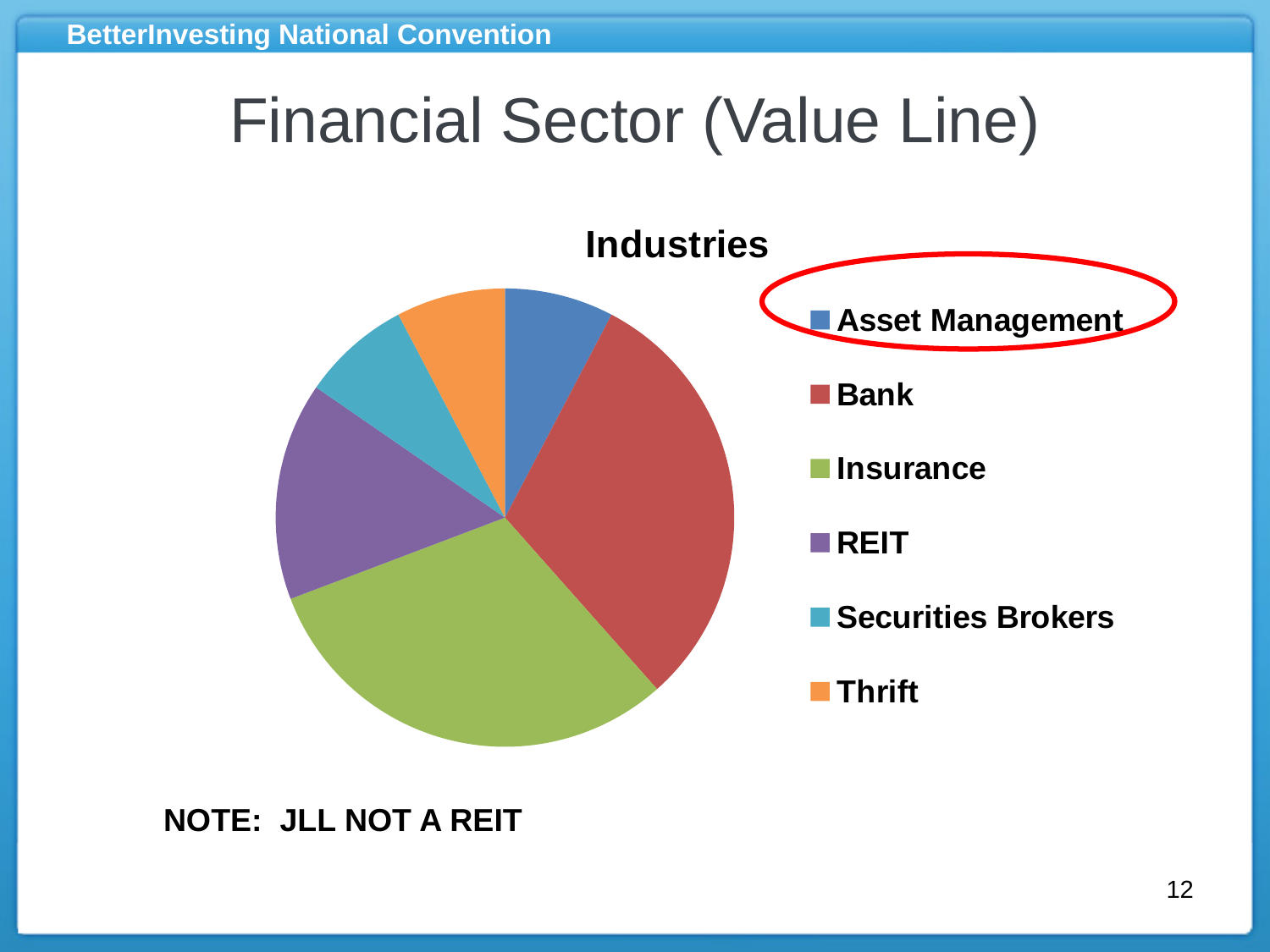
How many slices does the pie chart have? 6 Which slice is larger, Insurance or REIT? Insurance How many entries does the legend of the pie chart list? 6 Which slice is larger, Bank or REIT? Bank Which legend entry is circled in red? Asset Management Which slice is larger, Asset Management or Bank? Bank What is the title of the pie chart? Industries What kind of chart is shown on the slide? pie chart